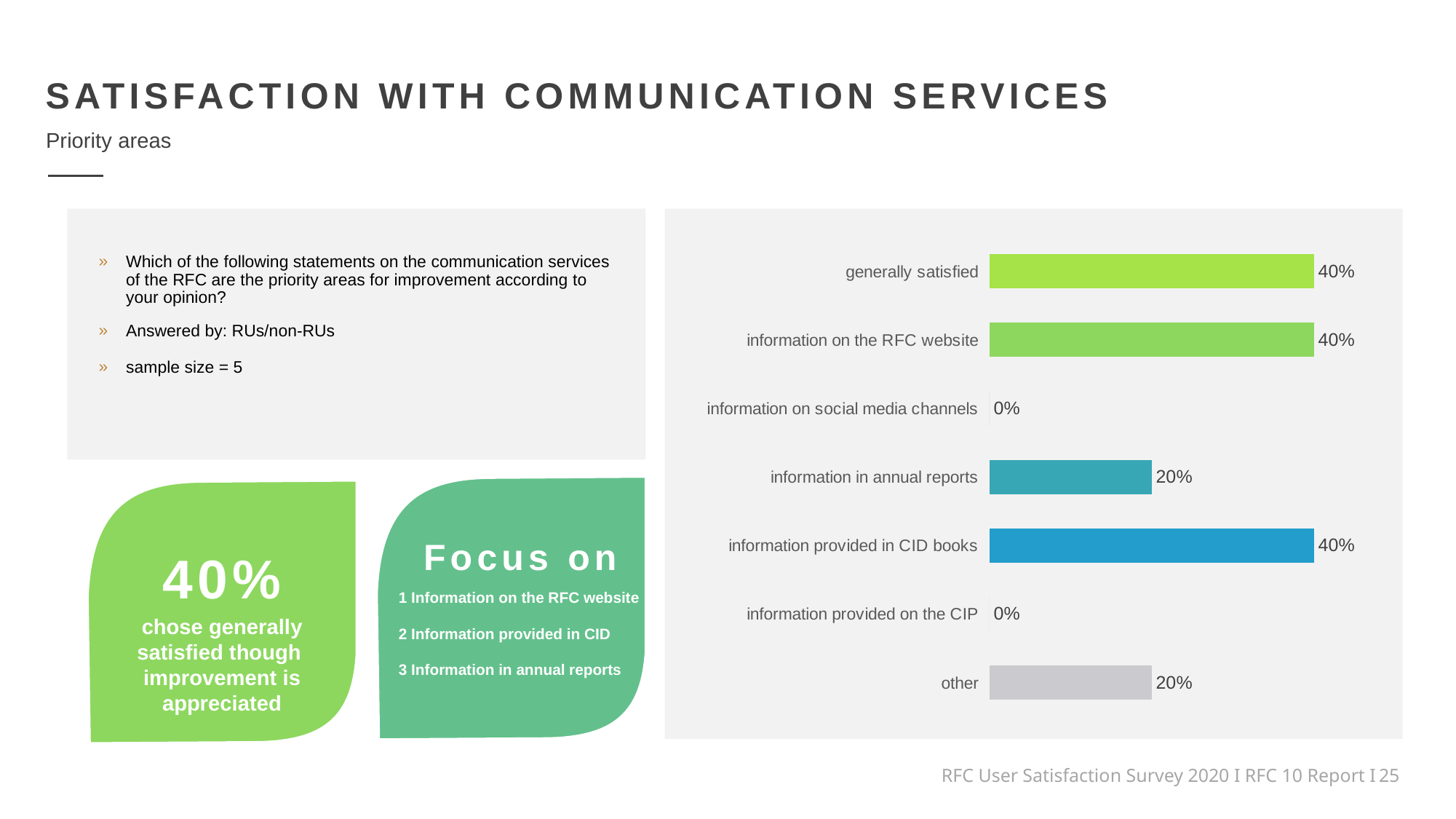
What is the value for "information in annual reports"? 20% Which is larger, the value for "information in annual reports" or the value for "information on social media channels"? information in annual reports How many categories in the chart have a value of 0%? 2 Which is larger, the value for "information on the RFC website" or the value for "other"? information on the RFC website What is the value for "information provided in CID books"? 40% What is the value for "information on social media channels"? 0% What is the difference between the values for "generally satisfied" and "information in annual reports"? 20% What is the sample size stated on the slide for this chart? 5 What kind of chart is shown on the slide? bar chart What is the value for "information provided on the CIP"? 0% What is the value for "other"? 20% How many categories are shown in the bar chart? 7